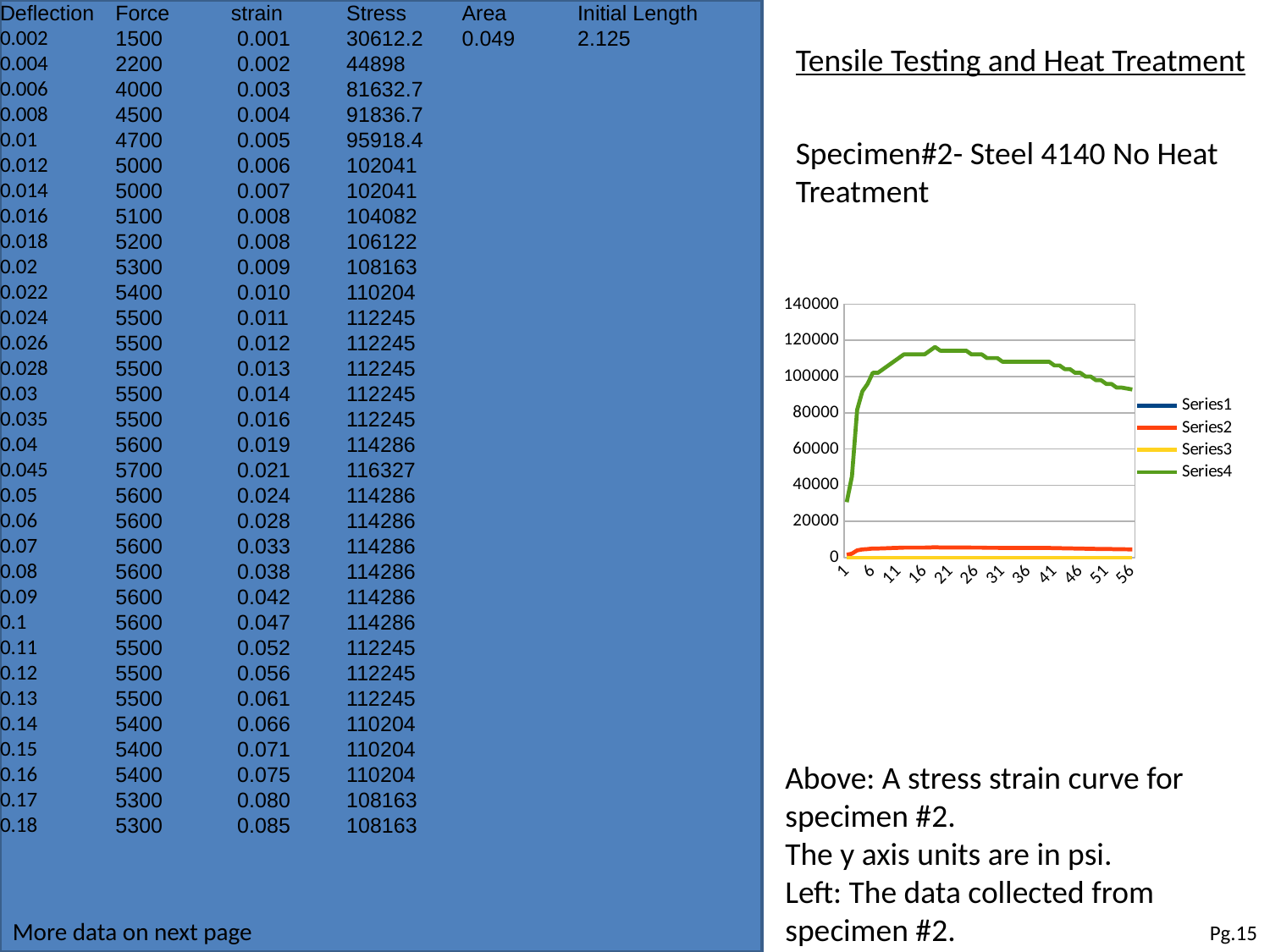
Is the value of Series4 at x = 1 greater or less than 40000? less At x = 26, which is larger, Series4 or Series2? Series4 What is the highest tick value shown on the chart's y axis? 140000 How many series does the chart's legend list? 4 What colour is the line for Series4 in the chart? green Does Series4 rise or fall between x = 1 and x = 11? rise What kind of chart is shown on the slide? line chart Is the value of Series2 at x = 26 greater or less than 20000? less Is the peak value of Series4 greater or less than 100000? greater Does Series4 rise or fall between x = 36 and x = 56? fall Which series reaches the highest values in the chart? Series4 What are the legend entries of the chart? Series1, Series2, Series3, Series4